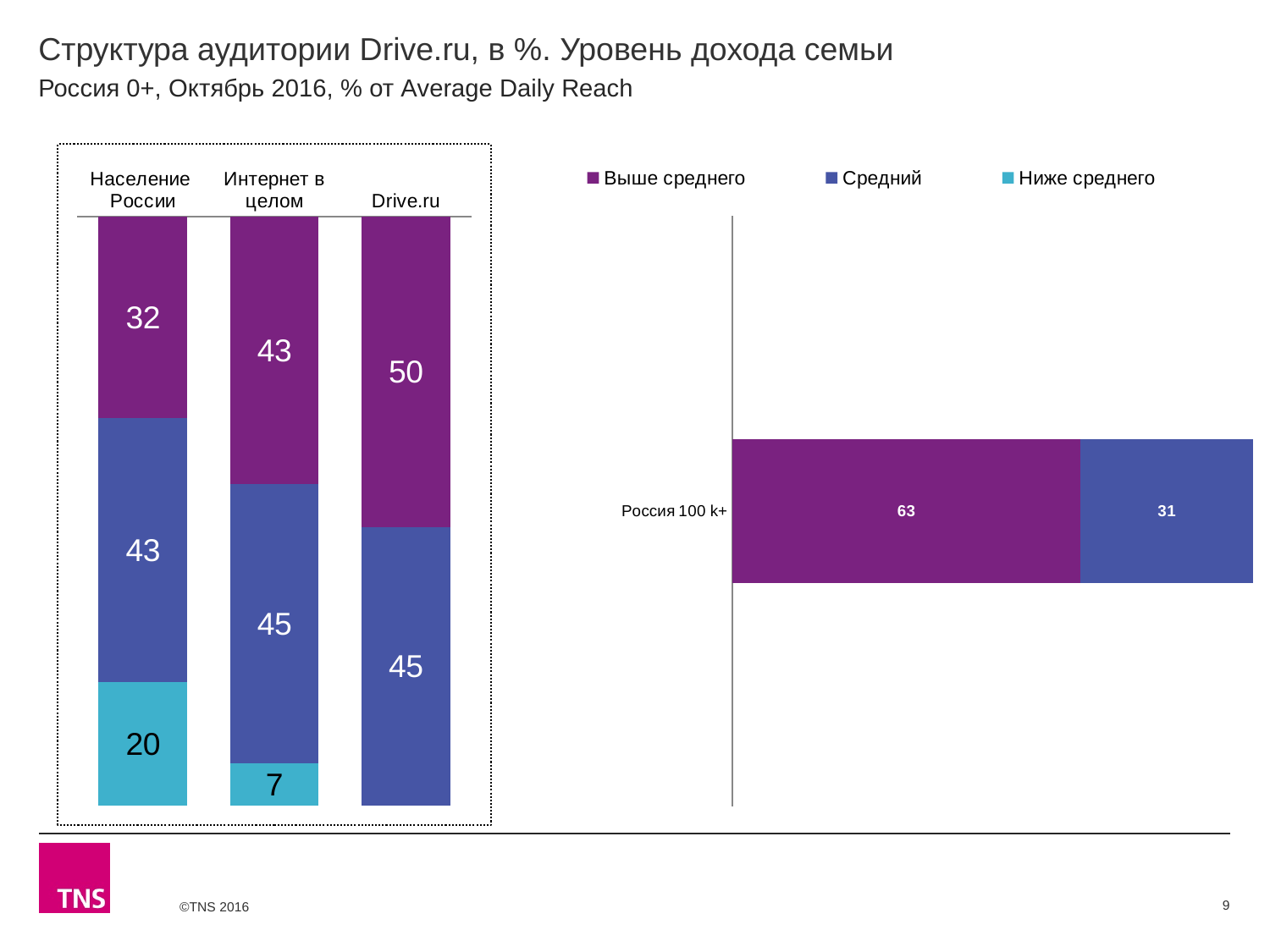
In the right chart, what is the difference between the 'Выше среднего' and 'Средний' values for 'Россия 100 k+'? 32 What kind of chart is the right chart? Stacked bar chart In the left chart, what is the difference between the 'Выше среднего' values for Drive.ru and 'Население России'? 18 In the left chart, what is the value of the 'Выше среднего' segment for Drive.ru? 50 How many series does the legend list? 3 In the left chart, is the 'Средний' value larger for 'Население России' or for Drive.ru? Drive.ru In the right chart, what is the value of the 'Выше среднего' segment for 'Россия 100 k+'? 63 In the left chart, what is the value of the 'Средний' segment for 'Интернет в целом'? 45 In the left chart, which category has the highest 'Выше среднего' value? Drive.ru How many categories are shown on the x axis of the left chart? 3 In the left chart, what is the value of the 'Ниже среднего' segment for 'Население России'? 20